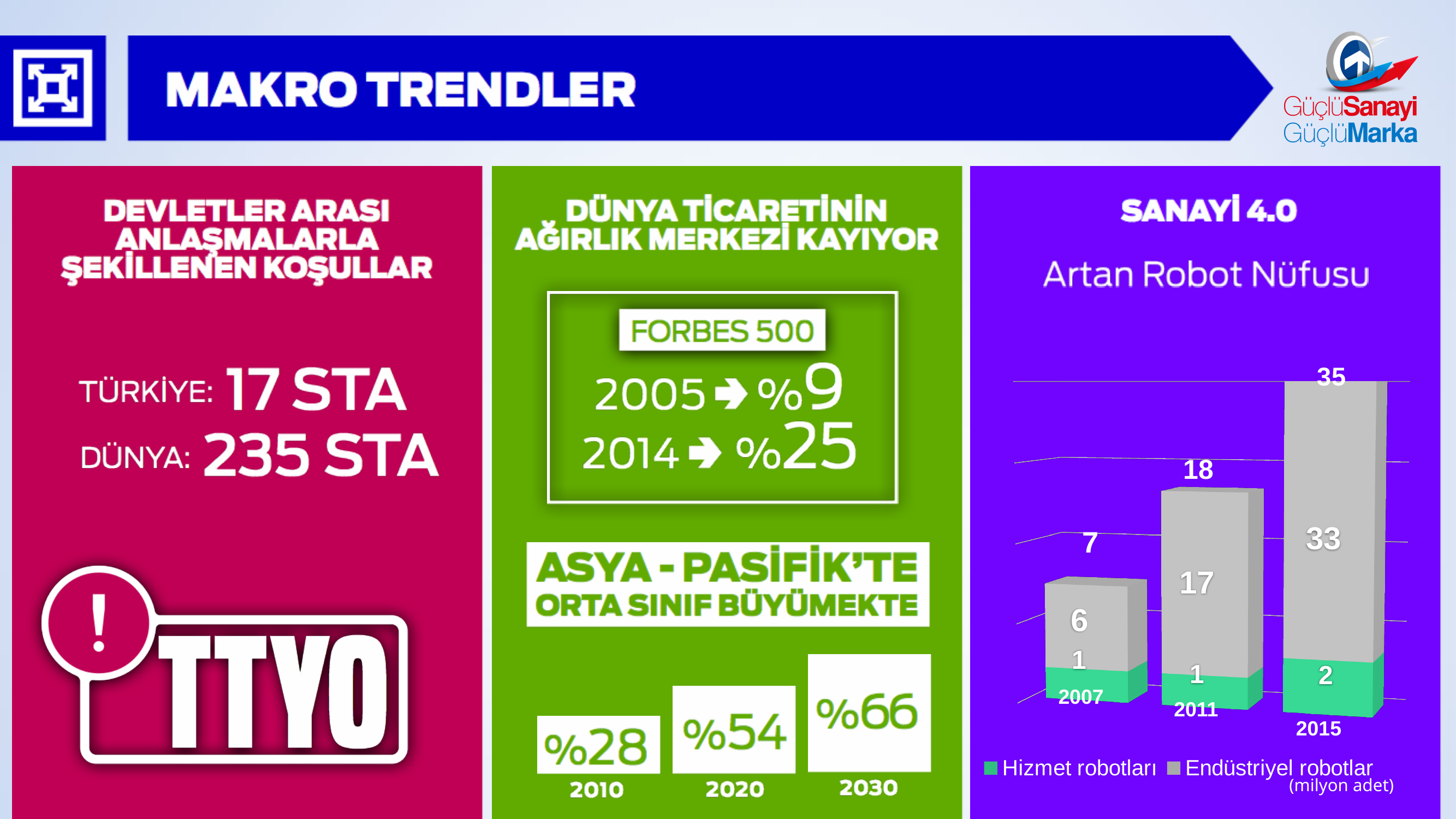
In the 'Artan Robot Nüfusu' chart, what is the value for Endüstriyel robotlar in 2015? 33 What kind of chart is shown in the 'Artan Robot Nüfusu' panel? Stacked bar chart How many series does the legend of the 'Artan Robot Nüfusu' chart list? 2 In the 'Artan Robot Nüfusu' chart, what is the value for Endüstriyel robotlar in 2007? 6 In the 'Artan Robot Nüfusu' chart, which year has the highest total? 2015 In the 'Artan Robot Nüfusu' chart, is the Endüstriyel robotlar value larger in 2011 or in 2007? 2011 In the 'Artan Robot Nüfusu' chart, what is the total of the stacked bar for 2011? 18 In the 'Artan Robot Nüfusu' chart, do the total values rise or fall from 2007 to 2015? Rise In the 'Artan Robot Nüfusu' chart, which year has the lowest total? 2007 In the 'Artan Robot Nüfusu' chart, what is the value for Hizmet robotları in 2011? 1 In the 'Artan Robot Nüfusu' chart, what is the difference between the Endüstriyel robotlar values for 2015 and 2011? 16 How many years are shown on the x axis of the 'Artan Robot Nüfusu' chart? 3